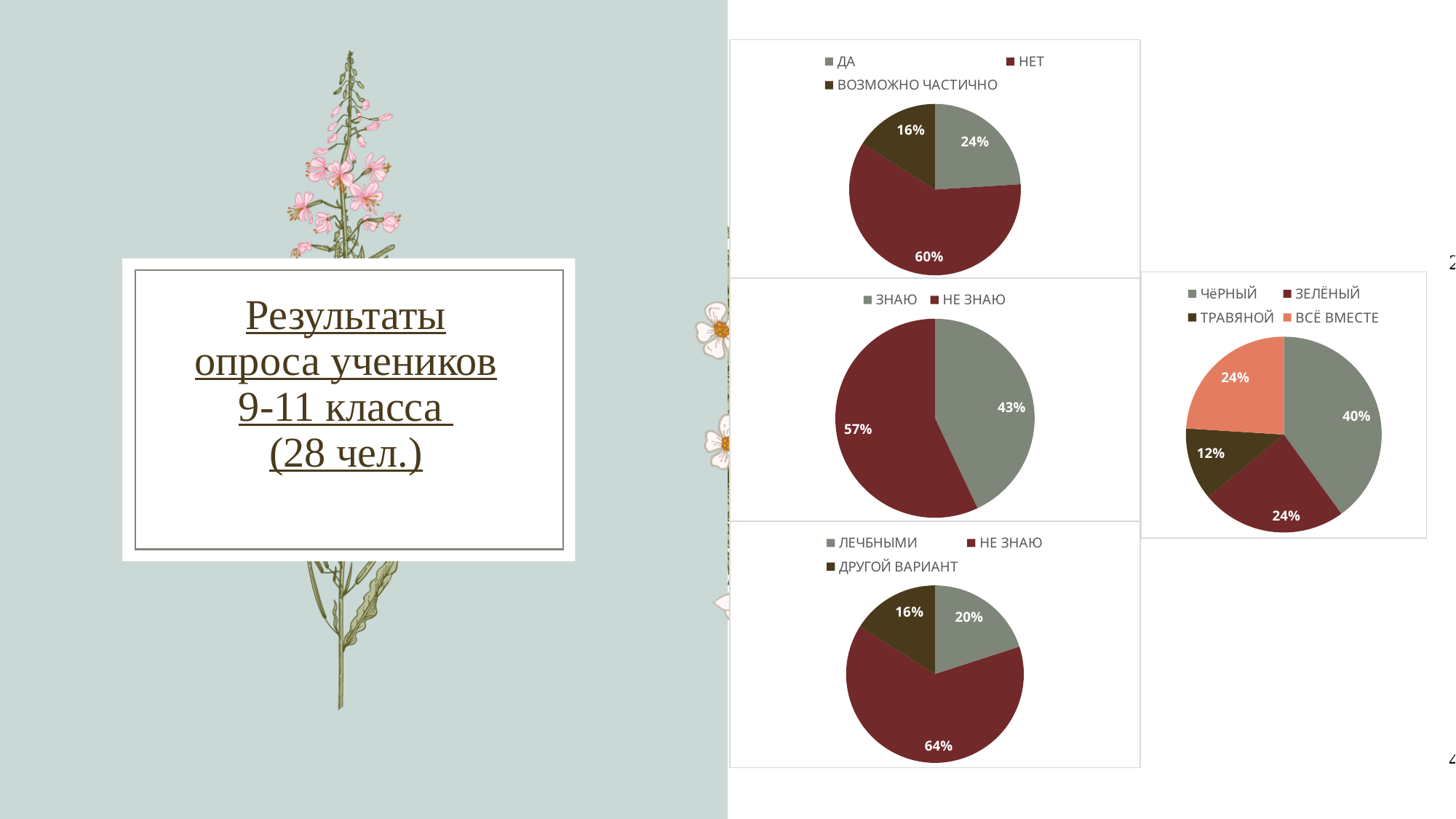
In the right-hand pie chart (legend ЧёРНЫЙ / ЗЕЛЁНЫЙ / ТРАВЯНОЙ / ВСЁ ВМЕСТЕ), how many categories does the legend list? 4 In the middle-left pie chart (legend ЗНАЮ / НЕ ЗНАЮ), which is larger, ЗНАЮ or НЕ ЗНАЮ? НЕ ЗНАЮ In the right-hand pie chart (legend ЧёРНЫЙ / ЗЕЛЁНЫЙ / ТРАВЯНОЙ / ВСЁ ВМЕСТЕ), which category has the largest share? ЧёРНЫЙ In the top-left pie chart (legend ДА / НЕТ / ВОЗМОЖНО ЧАСТИЧНО), what is the difference between the shares of НЕТ and ДА? 36% In the top-left pie chart (legend ДА / НЕТ / ВОЗМОЖНО ЧАСТИЧНО), which category has the smallest share? ВОЗМОЖНО ЧАСТИЧНО In the middle-left pie chart (legend ЗНАЮ / НЕ ЗНАЮ), what share does ЗНАЮ have? 43% In the right-hand pie chart (legend ЧёРНЫЙ / ЗЕЛЁНЫЙ / ТРАВЯНОЙ / ВСЁ ВМЕСТЕ), what share does ТРАВЯНОЙ have? 12% What kind of chart is the right-hand chart with the legend ЧёРНЫЙ / ЗЕЛЁНЫЙ / ТРАВЯНОЙ / ВСЁ ВМЕСТЕ? Pie chart In the bottom-left pie chart (legend ЛЕЧБНЫМИ / НЕ ЗНАЮ / ДРУГОЙ ВАРИАНТ), what share does ЛЕЧБНЫМИ have? 20% In the bottom-left pie chart (legend ЛЕЧБНЫМИ / НЕ ЗНАЮ / ДРУГОЙ ВАРИАНТ), which category has the largest share? НЕ ЗНАЮ In the top-left pie chart (legend ДА / НЕТ / ВОЗМОЖНО ЧАСТИЧНО), what share does НЕТ have? 60% In the middle-left pie chart (legend ЗНАЮ / НЕ ЗНАЮ), how many slices does the pie have? 2